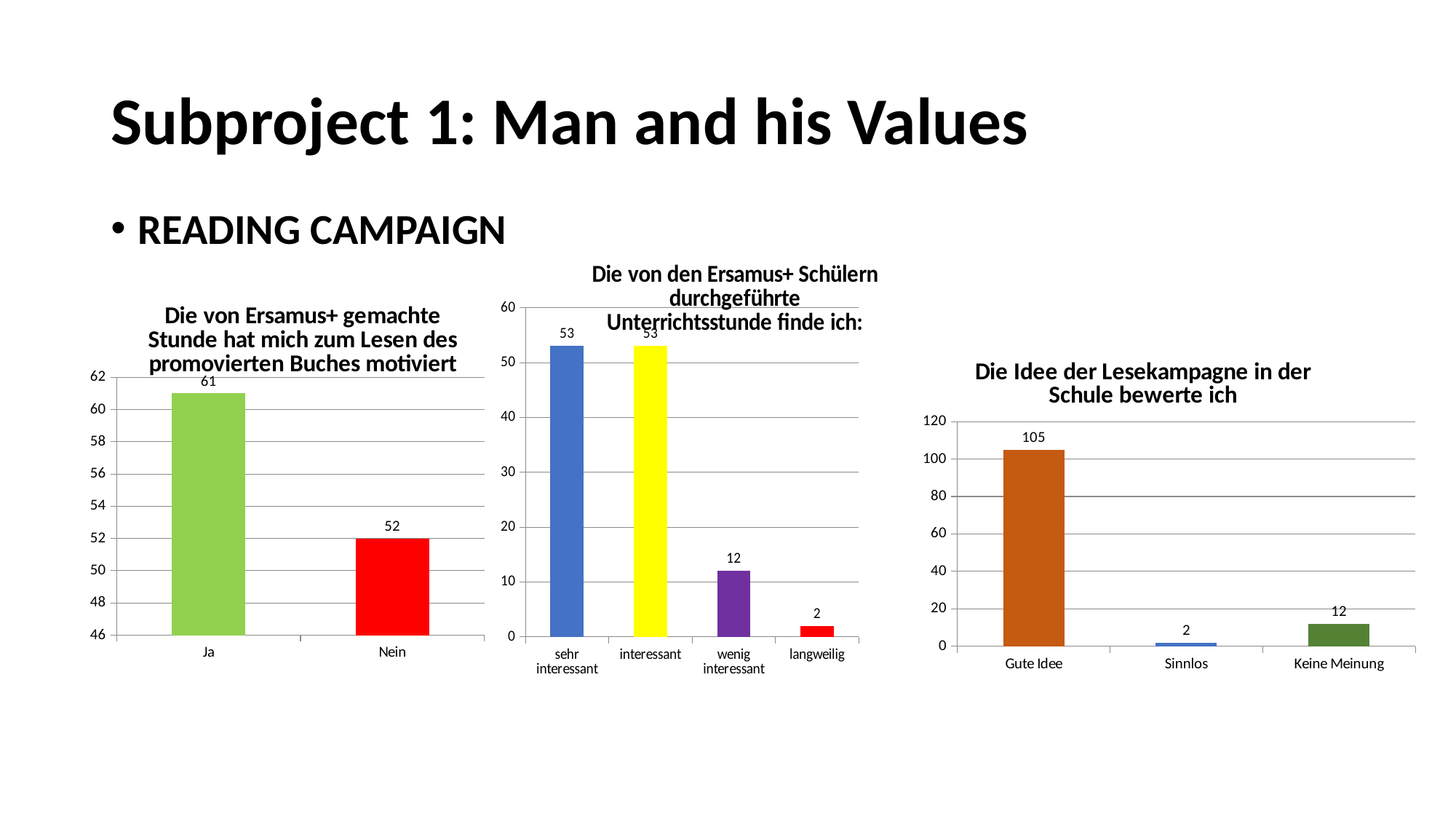
In the right chart ("Die Idee der Lesekampagne in der Schule bewerte ich"), what is the value for "Gute Idee"? 105 In the right chart, what is the difference between the values for "Keine Meinung" and "Sinnlos"? 10 In the middle chart, how many categories are shown? 4 In the left chart, what is the difference between the values for "Ja" and "Nein"? 9 In the left chart, what is the value for "Nein"? 52 In the right chart, is the value for "Keine Meinung" larger or smaller than the value for "Sinnlos"? larger In the left chart ("Die von Ersamus+ gemachte Stunde hat mich zum Lesen des promovierten Buches motiviert"), what is the value for "Ja"? 61 What type of chart is the right chart ("Die Idee der Lesekampagne in der Schule bewerte ich")? bar chart In the middle chart ("Die von den Ersamus+ Schülern durchgeführte Unterrichtsstunde finde ich:"), what is the value for "wenig interessant"? 12 In the middle chart, which category has the lowest value? langweilig In the right chart, which category has the highest value? Gute Idee In the middle chart, what is the value for "langweilig"? 2